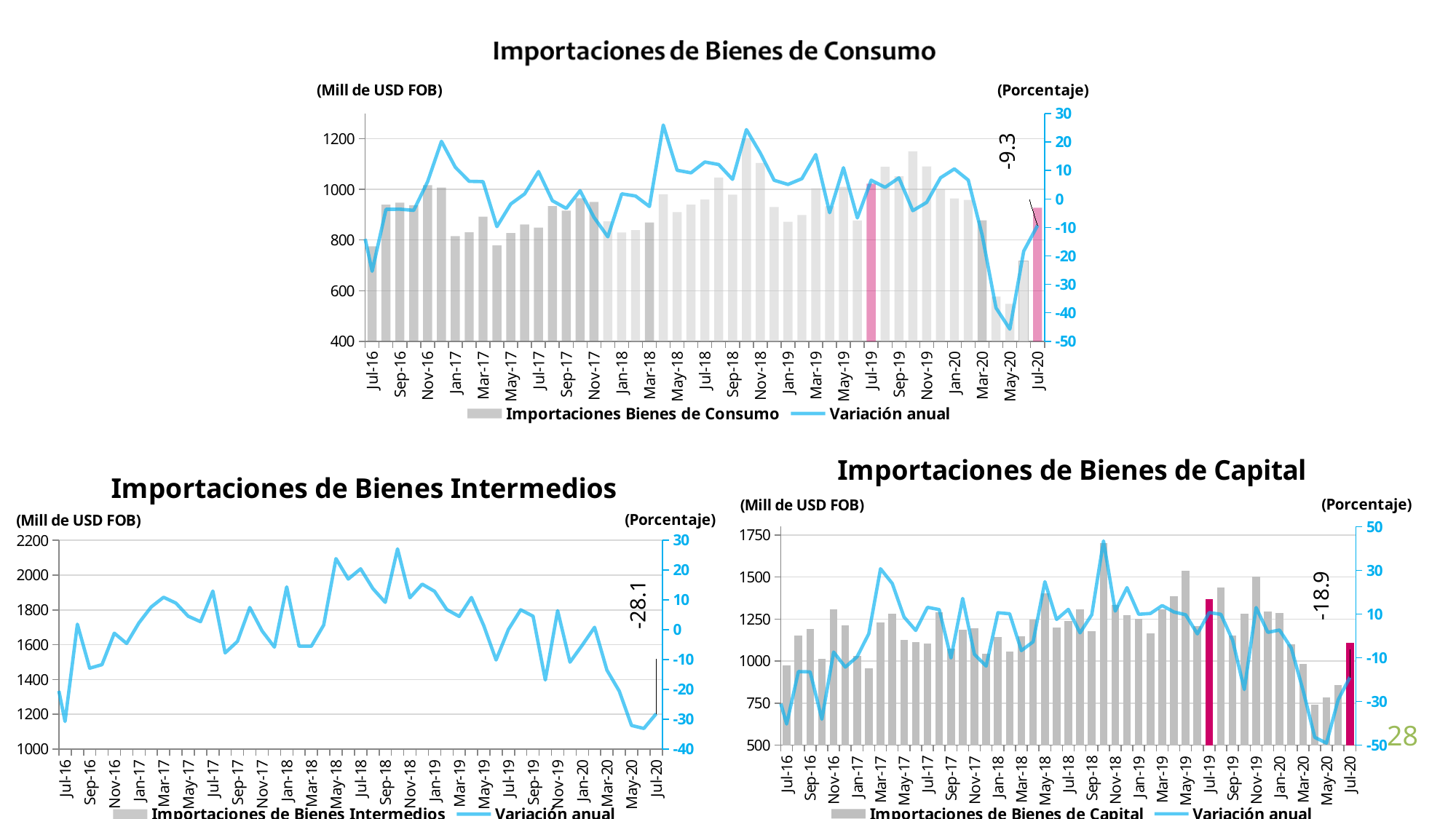
In the 'Importaciones de Bienes de Capital' chart, is the bar value for May-20 greater or less than 1000? less In the 'Importaciones de Bienes Intermedios' chart, what is the annual variation value labelled for Jul-20? -28.1 In the 'Importaciones de Bienes de Capital' chart, is the bar value for Jul-19 greater or less than 1250? greater How many series does the legend of the 'Importaciones de Bienes de Capital' chart list? 2 What unit label is shown above the right-hand axis of the 'Importaciones de Bienes Intermedios' chart? (Porcentaje) In the 'Importaciones de Bienes de Consumo' chart, in which month does the annual variation line reach its lowest point? May-20 In the 'Importaciones de Bienes de Consumo' chart, what is the annual variation (Variación anual) value labelled for Jul-20? -9.3 In the 'Importaciones de Bienes de Consumo' chart, is the bar value for Jul-20 greater or less than 800? greater In the 'Importaciones de Bienes de Consumo' chart, which bar is taller, Jul-19 or Jul-20? Jul-19 What kind of chart is 'Importaciones de Bienes de Consumo'? Combined bar and line chart In the 'Importaciones de Bienes de Consumo' chart, does the annual variation line rise or fall from May-20 to Jul-20? rise In the 'Importaciones de Bienes de Capital' chart, what is the annual variation value labelled for Jul-20? -18.9